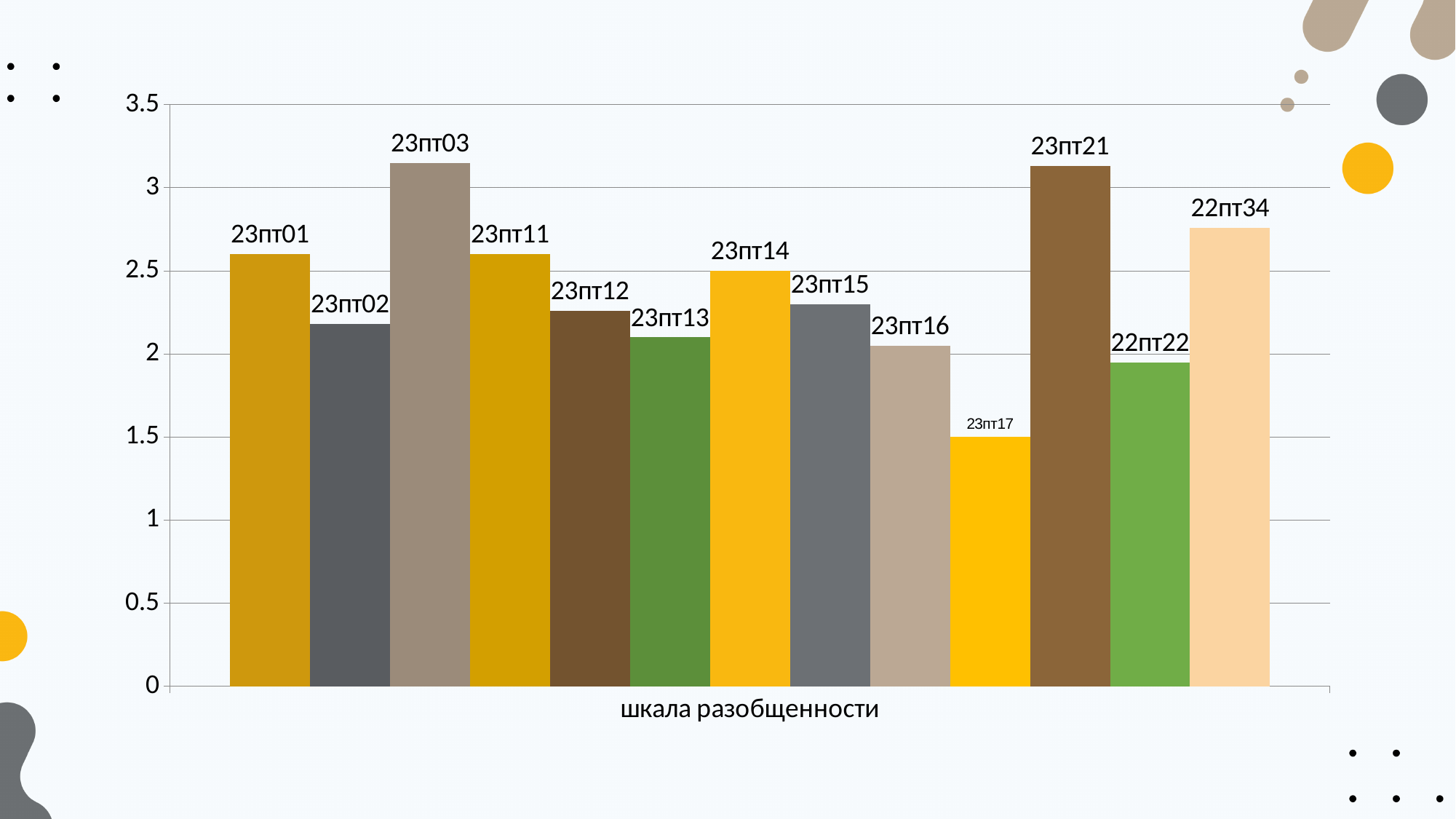
What kind of chart is shown on the slide? bar chart Is the value for 22пт22 greater or less than 2? less What is the label shown on the horizontal axis of the chart? шкала разобщенности Which is larger, the value for 23пт01 or the value for 23пт02? 23пт01 How many bars are plotted in the chart? 13 Which category has the lowest value in the chart? 23пт17 Is the value for 22пт34 greater or less than 3? less Is the value for 23пт03 greater or less than 3? greater What is the value for 23пт14? 2.5 What is the value for 23пт17? 1.5 Which is larger, the value for 22пт34 or the value for 22пт22? 22пт34